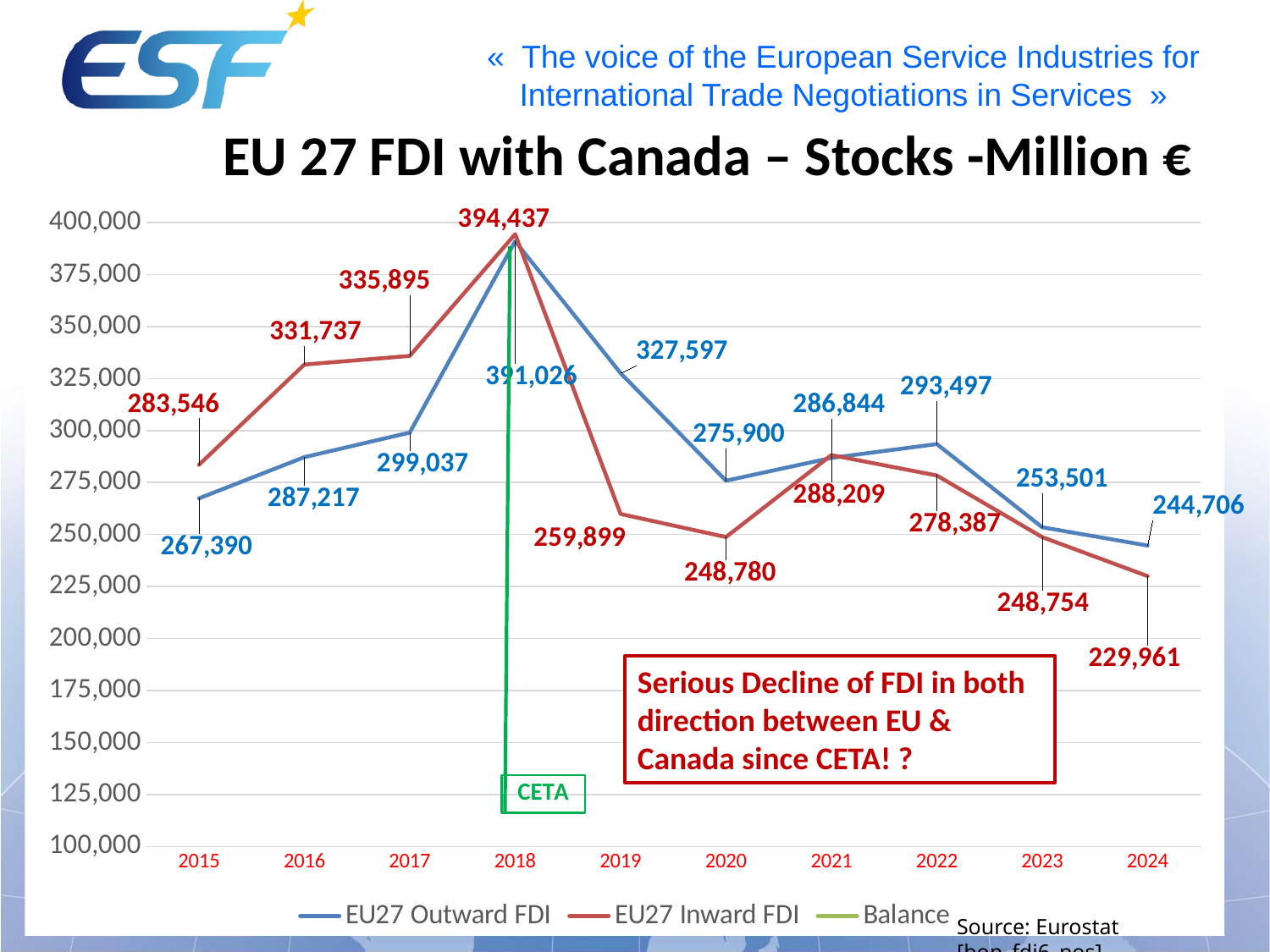
What is the difference between EU27 Inward FDI and EU27 Outward FDI in 2018? 3,411 In 2016, which is larger: EU27 Outward FDI or EU27 Inward FDI? EU27 Inward FDI What is the difference between EU27 Outward FDI and EU27 Inward FDI in 2024? 14,745 How many years are shown on the x axis? 10 In which year does EU27 Inward FDI reach its highest value? 2018 What kind of chart is shown on the slide? line chart What is the EU27 Outward FDI stock in 2018? 391,026 In which year is EU27 Outward FDI at its lowest? 2024 Does EU27 Outward FDI rise or fall from 2018 to 2020? fall What is the EU27 Inward FDI stock in 2024? 229,961 Is the EU27 Inward FDI value for 2019 greater or less than 275,000? less How many series does the legend list? 3